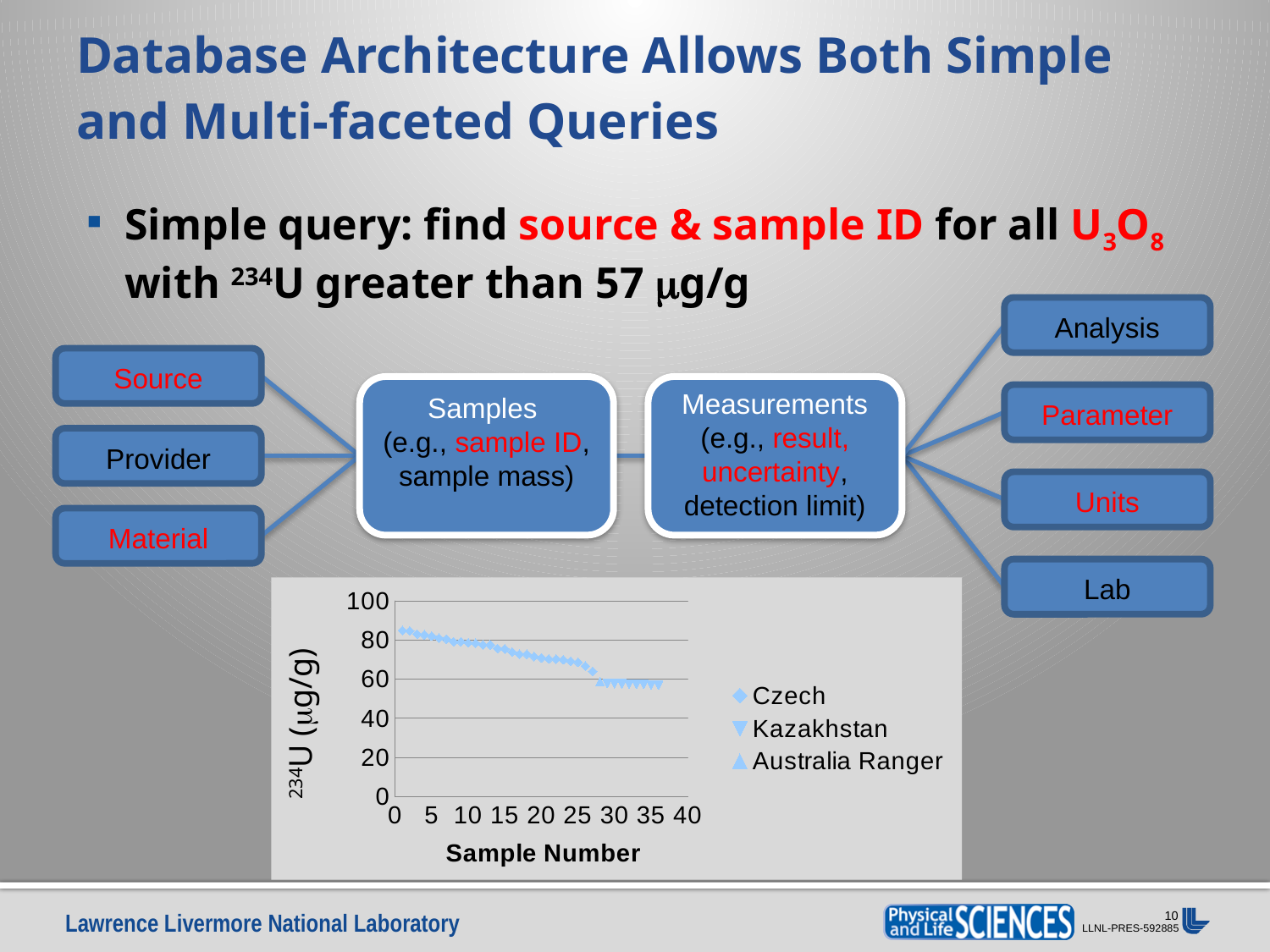
What kind of chart is shown at the bottom of the slide? scatter chart What are the three series named in the chart legend? Czech, Kazakhstan, Australia Ranger Which series has the lowest 234U values plotted on the chart? Kazakhstan Which series has higher 234U values, Czech or Kazakhstan? Czech What is the maximum value shown on the y axis of the chart? 100 Are the Czech values greater or less than 100 µg/g? less Are the Czech values greater or less than 60 µg/g? greater How many series does the chart legend list? 3 What is the title of the x axis of the chart? Sample Number Are the Kazakhstan values greater or less than 40 µg/g? greater Do the Czech values rise or fall as the sample number increases? fall